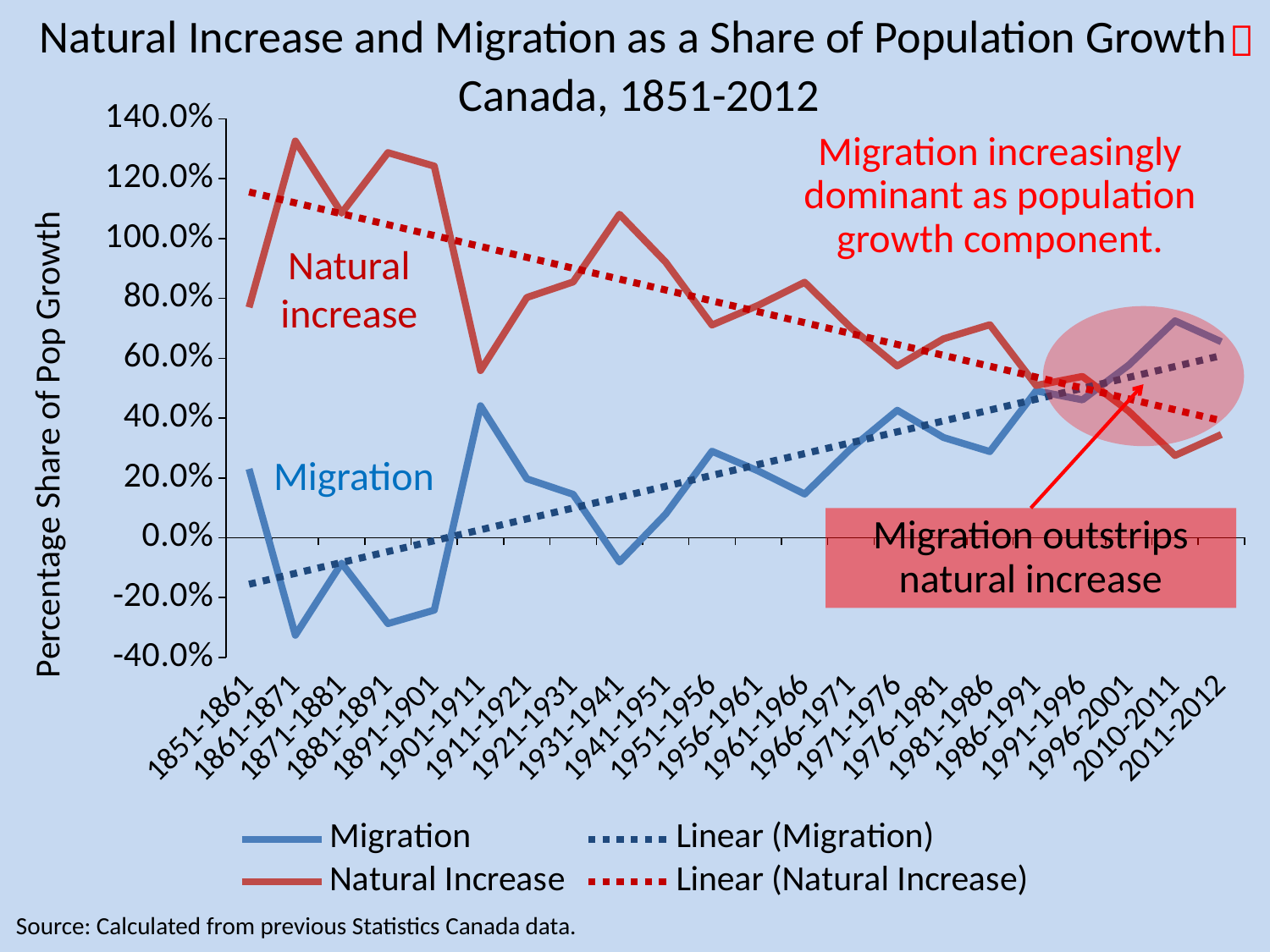
Is the Natural Increase value for 1861-1871 greater or less than 120.0%? greater Is the Migration value for 1861-1871 greater or less than -20.0%? less What kind of chart is shown on the slide? line chart In 1851-1861, which series has the larger value, Migration or Natural Increase? Natural Increase In 2010-2011, which series has the larger value, Migration or Natural Increase? Migration Is the Migration value for 1931-1941 greater or less than 0.0%? less Does the Natural Increase series generally rise or fall across the periods from 1851-1861 to 2011-2012? fall How many time periods are shown along the x axis? 22 How many entries does the legend list? 4